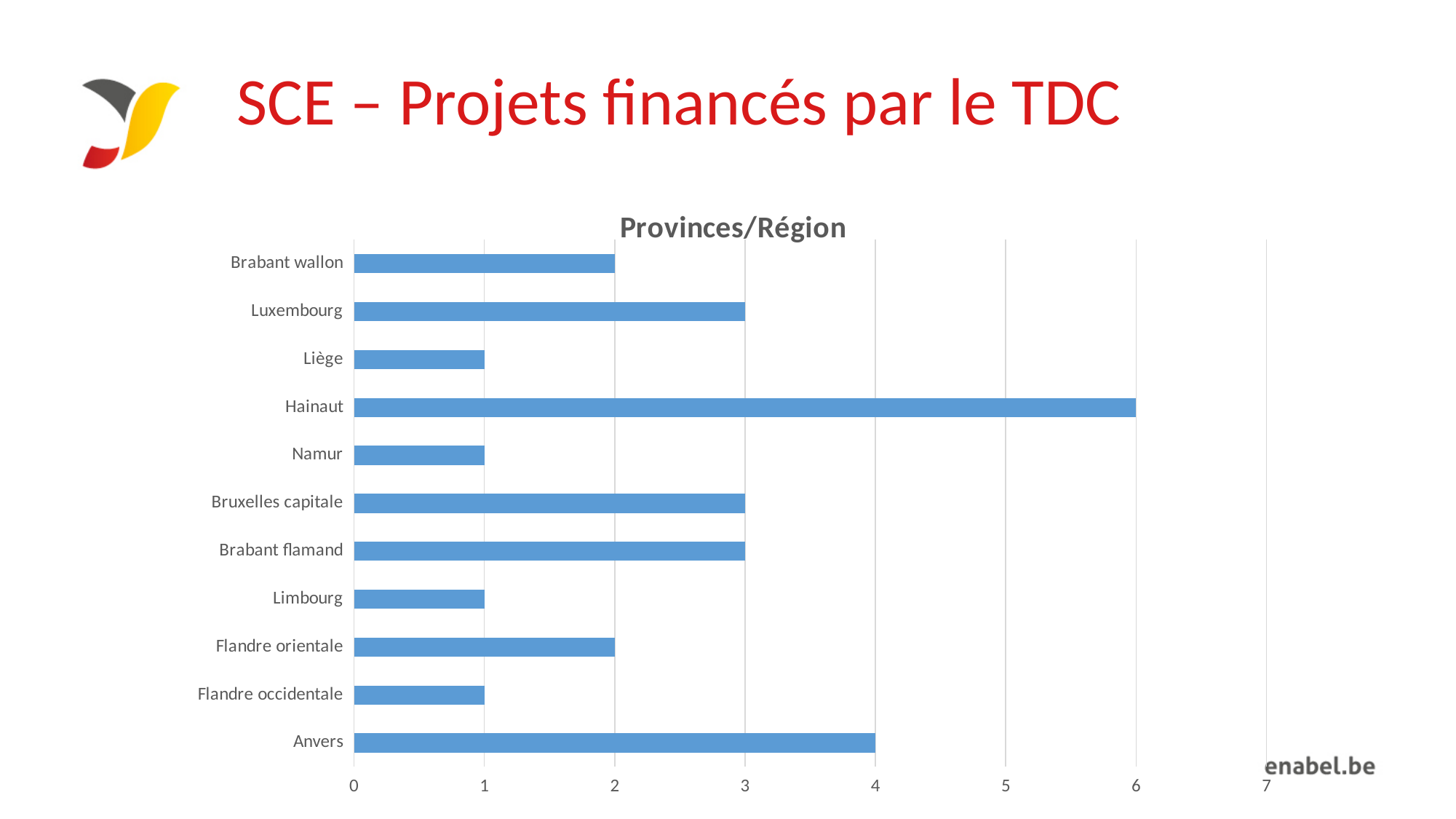
What is the value for Hainaut? 6 What is the value for Brabant wallon? 2 What type of chart is shown on the slide? bar chart What is the value for Luxembourg? 3 What is the difference between the values for Hainaut and Anvers? 2 How many provinces/regions are listed on the chart? 11 Which has a larger value, Anvers or Bruxelles capitale? Anvers What is the value for Anvers? 4 What is the value for Liège? 1 Is the value for Hainaut greater or less than 5? greater Which province/region has the highest value? Hainaut What is the title of the chart? Provinces/Région